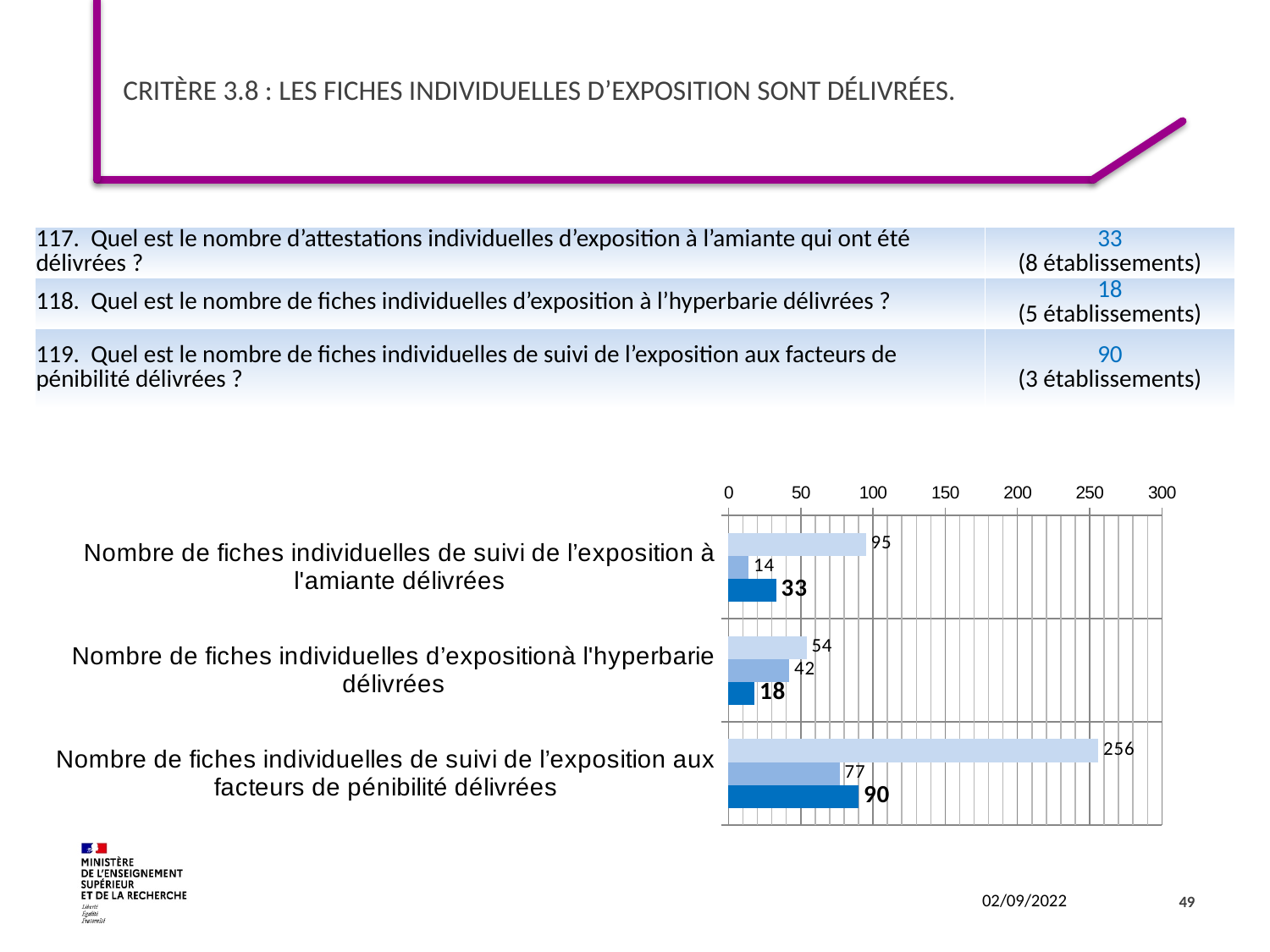
For 'Nombre de fiches individuelles de suivi de l'exposition à l'amiante délivrées', which is larger: the medium blue bar or the dark blue bar? the dark blue bar What is the value of the medium blue bar for 'Nombre de fiches individuelles d'exposition à l'hyperbarie délivrées'? 42 Is the value of the lightest blue bar for 'Nombre de fiches individuelles de suivi de l'exposition aux facteurs de pénibilité délivrées' greater or less than 250? greater Which category has the lowest value among the dark blue bars? Nombre de fiches individuelles d'exposition à l'hyperbarie délivrées What is the value of the lightest blue bar for 'Nombre de fiches individuelles de suivi de l'exposition aux facteurs de pénibilité délivrées'? 256 What is the value of the dark blue bar for 'Nombre de fiches individuelles de suivi de l'exposition à l'amiante délivrées'? 33 What is the maximum value shown on the chart's horizontal axis? 300 What is the difference between the lightest blue bar (256) and the dark blue bar (90) for 'Nombre de fiches individuelles de suivi de l'exposition aux facteurs de pénibilité délivrées'? 166 What is the value of the dark blue bar for 'Nombre de fiches individuelles d'exposition à l'hyperbarie délivrées'? 18 How many categories are shown on the chart? 3 What kind of chart is shown on the slide? bar chart Which category has the highest value among the lightest blue bars? Nombre de fiches individuelles de suivi de l'exposition aux facteurs de pénibilité délivrées